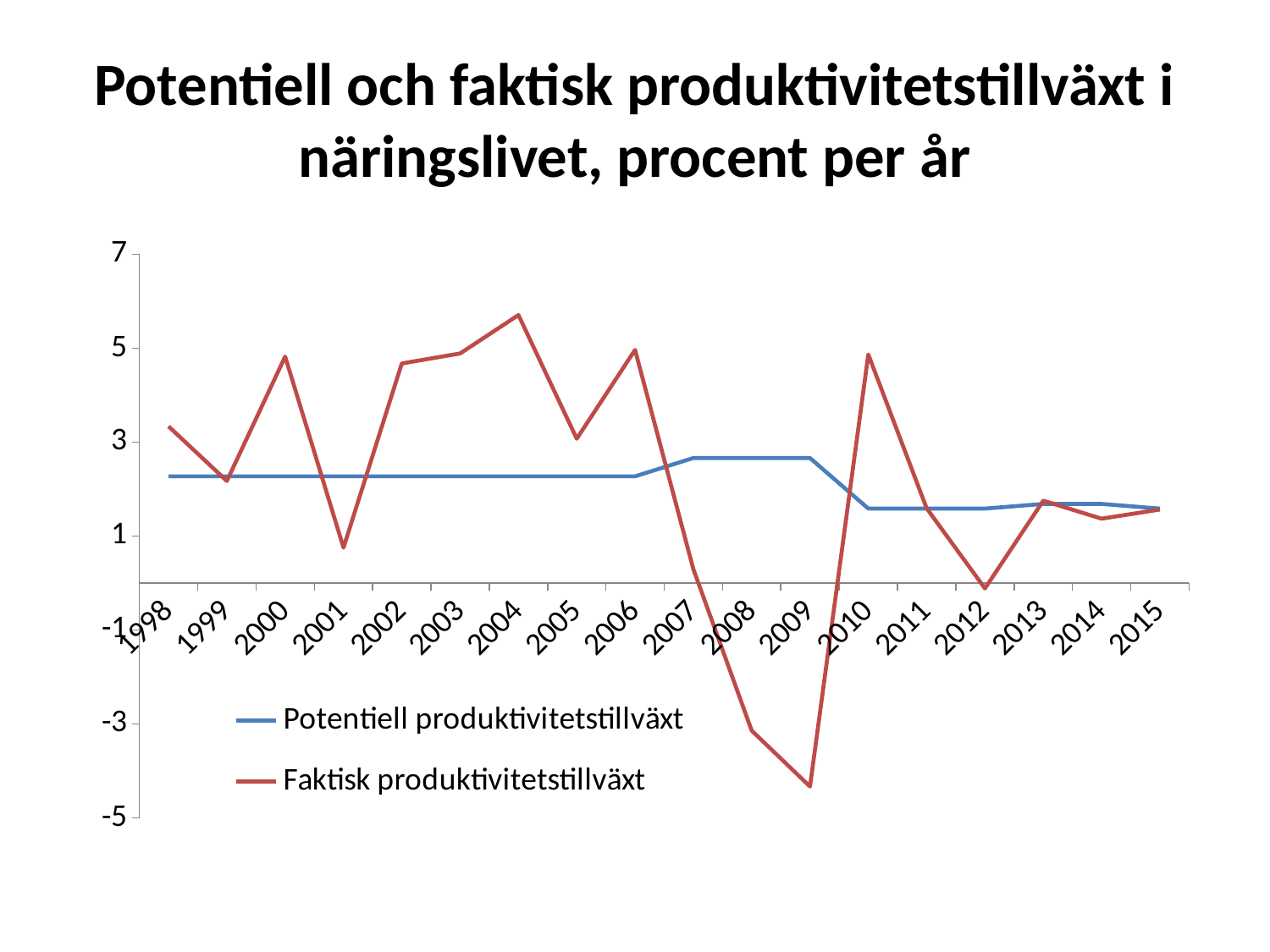
How many series does the legend list? 2 In which year does Faktisk produktivitetstillväxt reach its lowest value? 2009 What kind of chart is shown on the slide? line chart In which year does Faktisk produktivitetstillväxt reach its highest value? 2004 How many years are plotted along the x axis? 18 Is the value for Faktisk produktivitetstillväxt in 2004 greater or less than 5? greater Which colour is used for the Faktisk produktivitetstillväxt line? red Is the value for Faktisk produktivitetstillväxt in 2009 greater or less than -3? less Does Faktisk produktivitetstillväxt rise or fall from 2007 to 2009? fall In 2009, which series has the larger value, Potentiell produktivitetstillväxt or Faktisk produktivitetstillväxt? Potentiell produktivitetstillväxt Is the value for Faktisk produktivitetstillväxt in 2000 greater or less than 3? greater